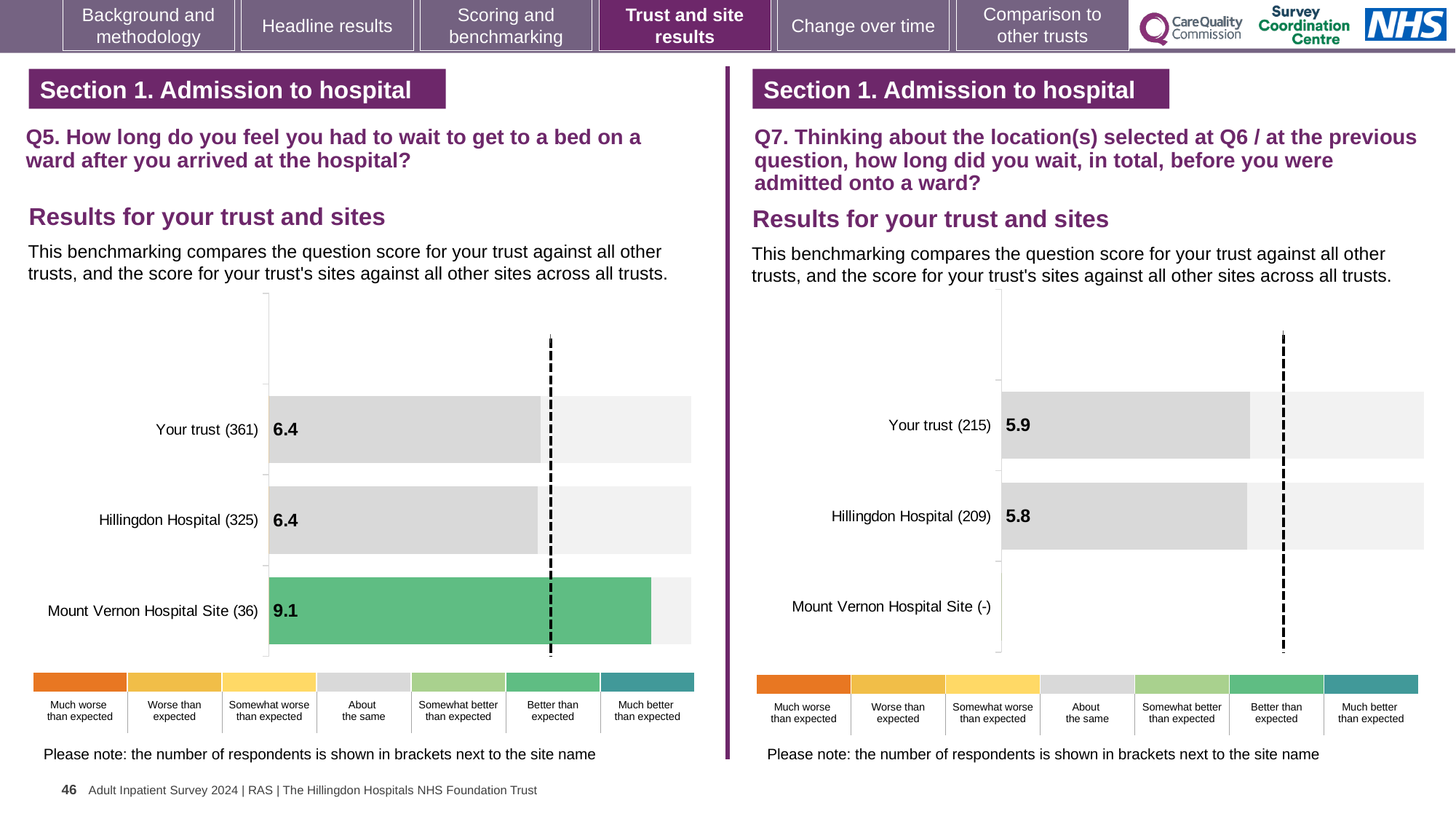
On the Q5 chart (left), which benchmark category does the Mount Vernon Hospital Site bar fall into, according to its colour? Better than expected On the Q5 chart (left), what is the score for Mount Vernon Hospital Site (36)? 9.1 On the Q7 chart (right), which is larger: the score for Your trust (215) or Hillingdon Hospital (209)? Your trust (215) On the Q5 chart (left), which site or trust has the highest score? Mount Vernon Hospital Site (36) On the Q5 chart (left), how many bars are plotted? 3 On the Q7 chart (right), what is the score for Your trust (215)? 5.9 On the Q7 chart (right), what is the difference between the scores for Your trust (215) and Hillingdon Hospital (209)? 0.1 On the Q7 chart (right), how many respondents are shown for Mount Vernon Hospital Site? - On the Q5 chart (left), what is the difference between the scores for Mount Vernon Hospital Site (36) and Hillingdon Hospital (325)? 2.7 What type of chart is used on the Q5 chart (left)? Bar chart On the Q7 chart (right), what is the score for Hillingdon Hospital (209)? 5.8 On the Q5 chart (left), what is the score for Your trust (361)? 6.4